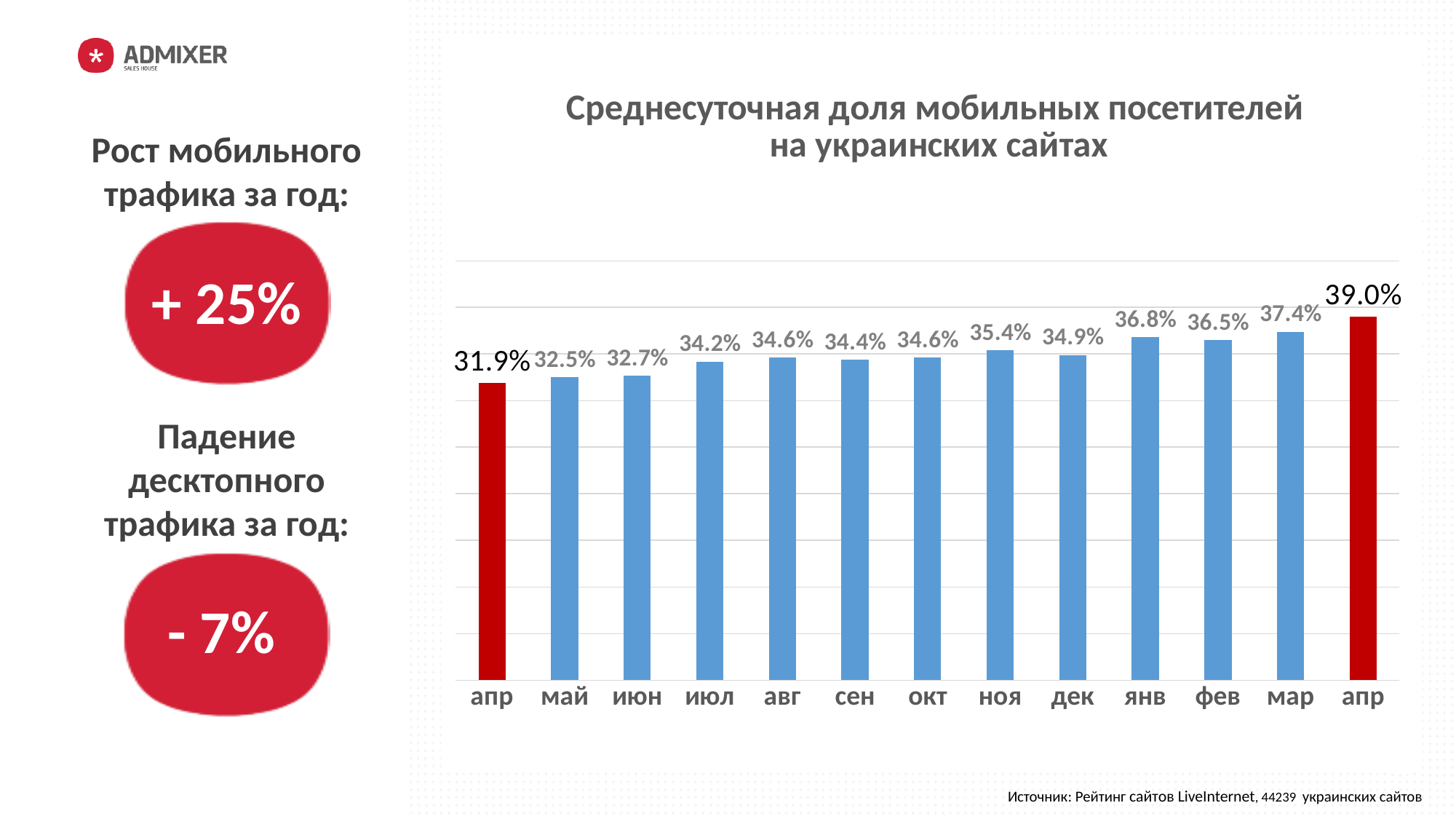
What is the value for янв? 36.8% Which month has the highest value in the chart? апр (rightmost) Which bar has the lowest value in the chart? апр (leftmost) What is the difference between the rightmost апр bar and the leftmost апр bar? 7.1% What is the value for the first апр bar (leftmost)? 31.9% Which is larger, the value for мар or the value for фев? мар How many bars are plotted in the chart? 13 What type of chart is shown on the slide? bar chart What is the title of the chart? Среднесуточная доля мобильных посетителей на украинских сайтах What is the value for ноя? 35.4% Do the values generally rise or fall from left to right along the x axis? rise What is the value for the last апр bar (rightmost)? 39.0%